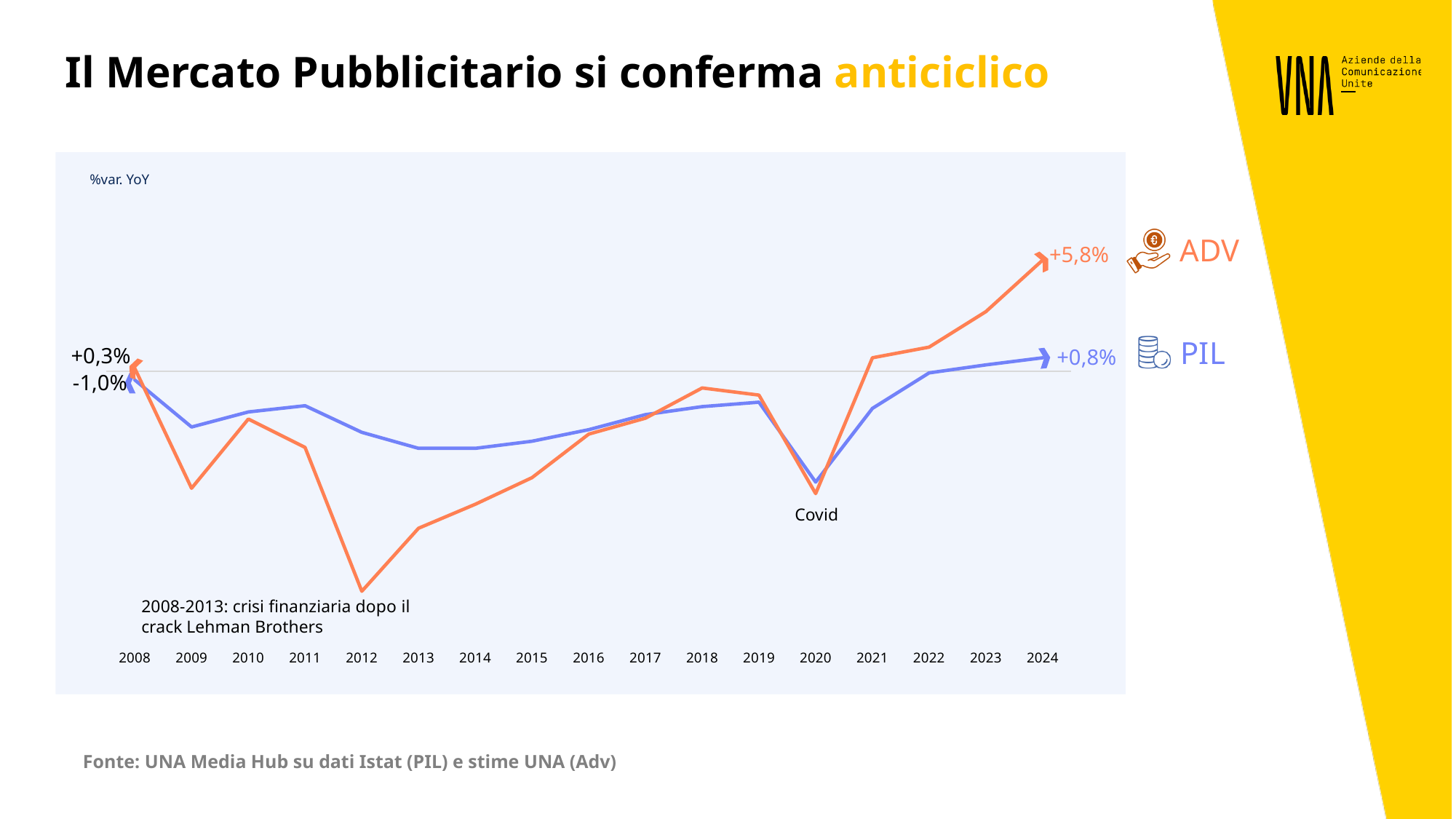
What is the value for PIL in 2008? -1,0% How many series are plotted on the chart? 2 In which year does the PIL line reach its lowest point? 2020 Does the ADV line rise or fall from 2020 to 2024? Rise How many years are shown on the x axis? 17 What is the value for ADV in 2008? +0,3% By how many percentage points does ADV exceed PIL in 2024? 5,0 percentage points What kind of chart is shown on the slide? Line chart In which year does the ADV line reach its lowest point? 2012 In 2024, which series has the higher value, ADV or PIL? ADV What is the value for PIL in 2024? +0,8% What is the value for ADV in 2024? +5,8%